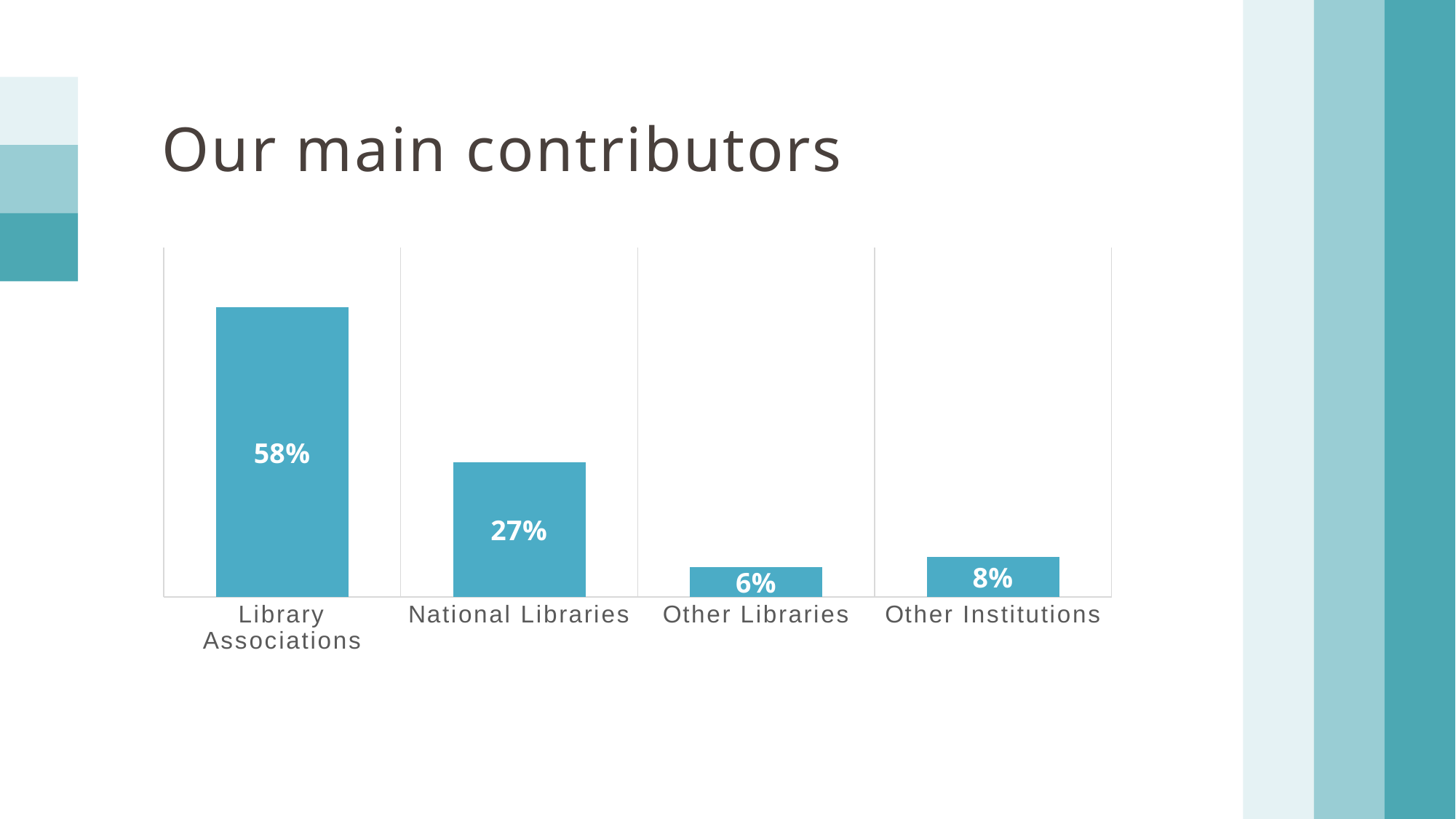
Which category has the highest value? Library Associations What is the value for National Libraries? 27% What is the value for Other Libraries? 6% What is the title of the slide containing the chart? Our main contributors What kind of chart is shown on the slide? Bar chart Which is larger, the value for National Libraries or the value for Other Institutions? National Libraries Which category has the lowest value? Other Libraries What is the difference between the values for Library Associations and National Libraries? 31% What is the value for Other Institutions? 8% How many categories are shown in the chart? 4 What is the difference between the values for Other Institutions and Other Libraries? 2% What is the value for Library Associations? 58%